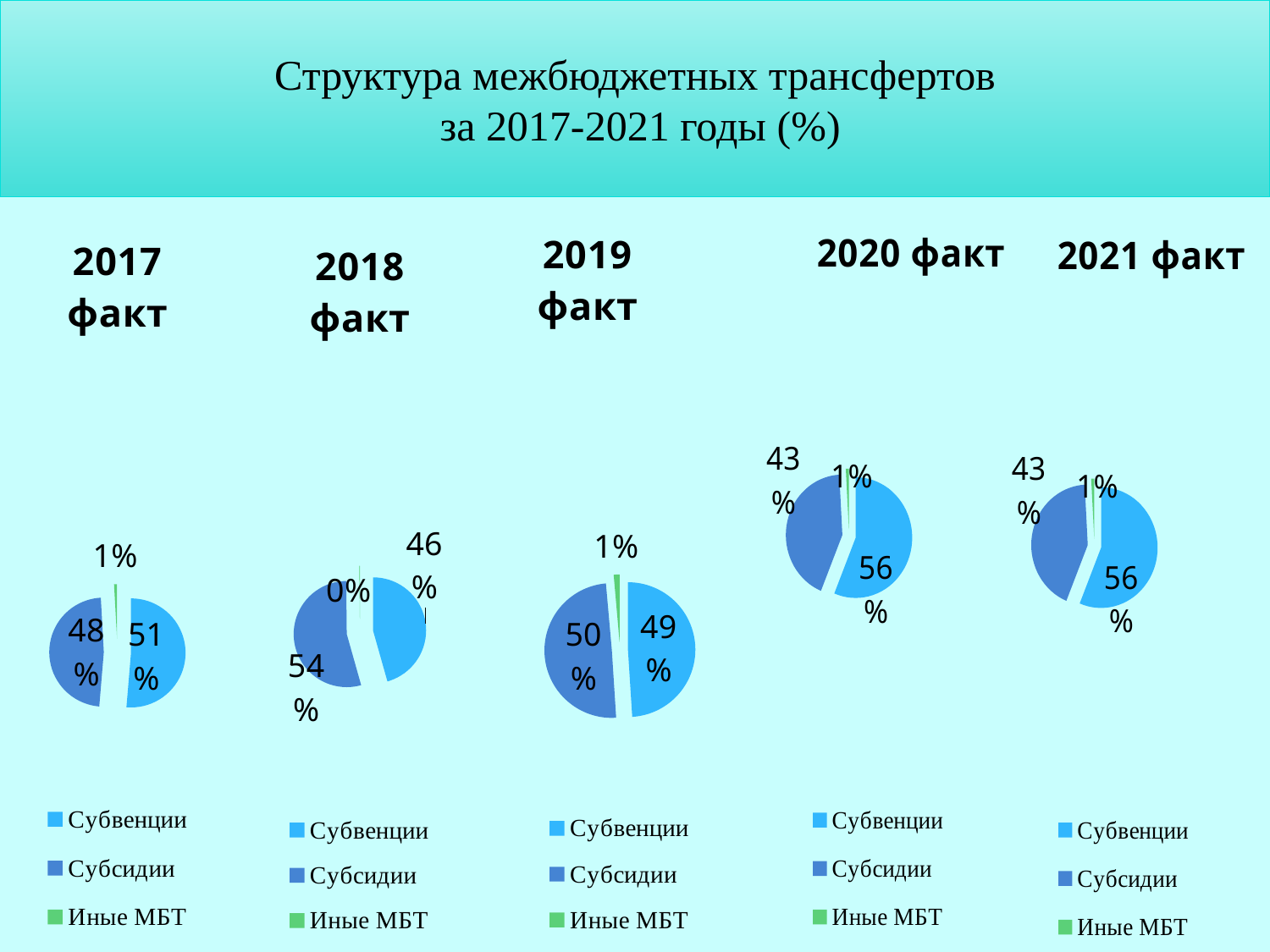
In the 2019 факт chart, what is the value for Иные МБТ? 1% In the 2017 факт chart, what is the value for Субвенции? 51% In the 2020 факт chart, which category has the smallest share? Иные МБТ In the 2018 факт chart, which is larger: Субвенции or Субсидии? Субсидии In the 2018 факт chart, what is the value for Субсидии? 54% How many pie charts are shown on the slide? 5 In the 2021 факт chart, what is the difference between Субвенции and Субсидии? 13% In the 2018 факт chart, which category has the largest share? Субсидии What kind of chart is used for 2019 факт? Pie chart In the 2020 факт chart, what is the value for Субвенции? 56% In the 2021 факт chart, what is the value for Субсидии? 43% How many categories does the legend of the 2017 факт chart list? 3